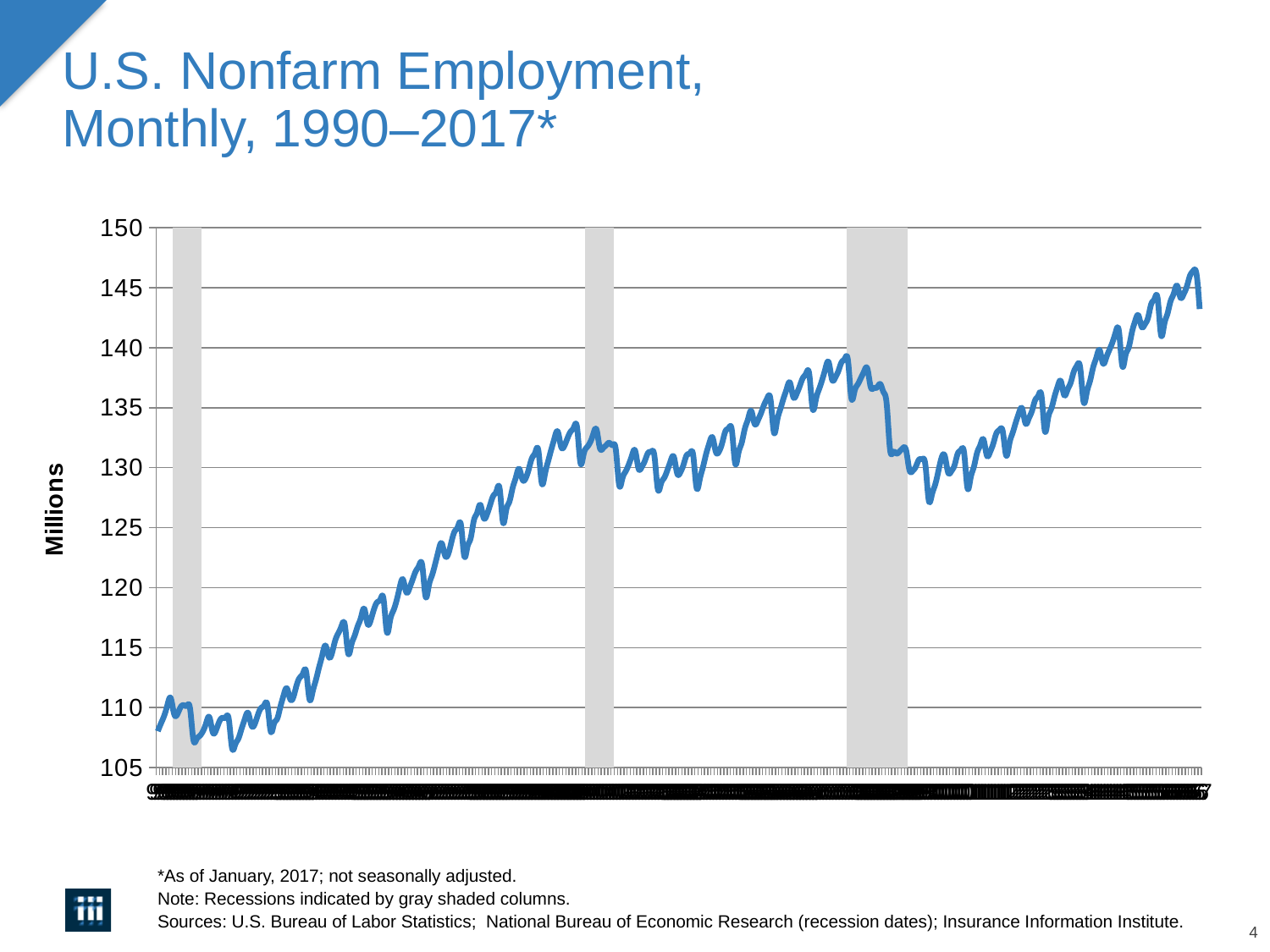
Is the highest value reached on the chart greater or less than 145? greater During the third (rightmost) gray shaded recession column, do the values rise or fall? fall Is the value at the end of the series (2017) larger or smaller than the value at the start of the series (1990)? larger Is the value at the start of the series (1990) greater or less than 115? less What kind of chart is shown on the slide? line chart How many gray shaded recession columns are shown on the chart? 3 What is the title of the chart on the slide? U.S. Nonfarm Employment, Monthly, 1990–2017* Is the value at the end of the series (January 2017) greater or less than 140? greater What is the label on the vertical axis of the chart? Millions Overall, do the values rise or fall from the start of the series in 1990 to the end in 2017? rise What is the highest value shown on the vertical axis? 150